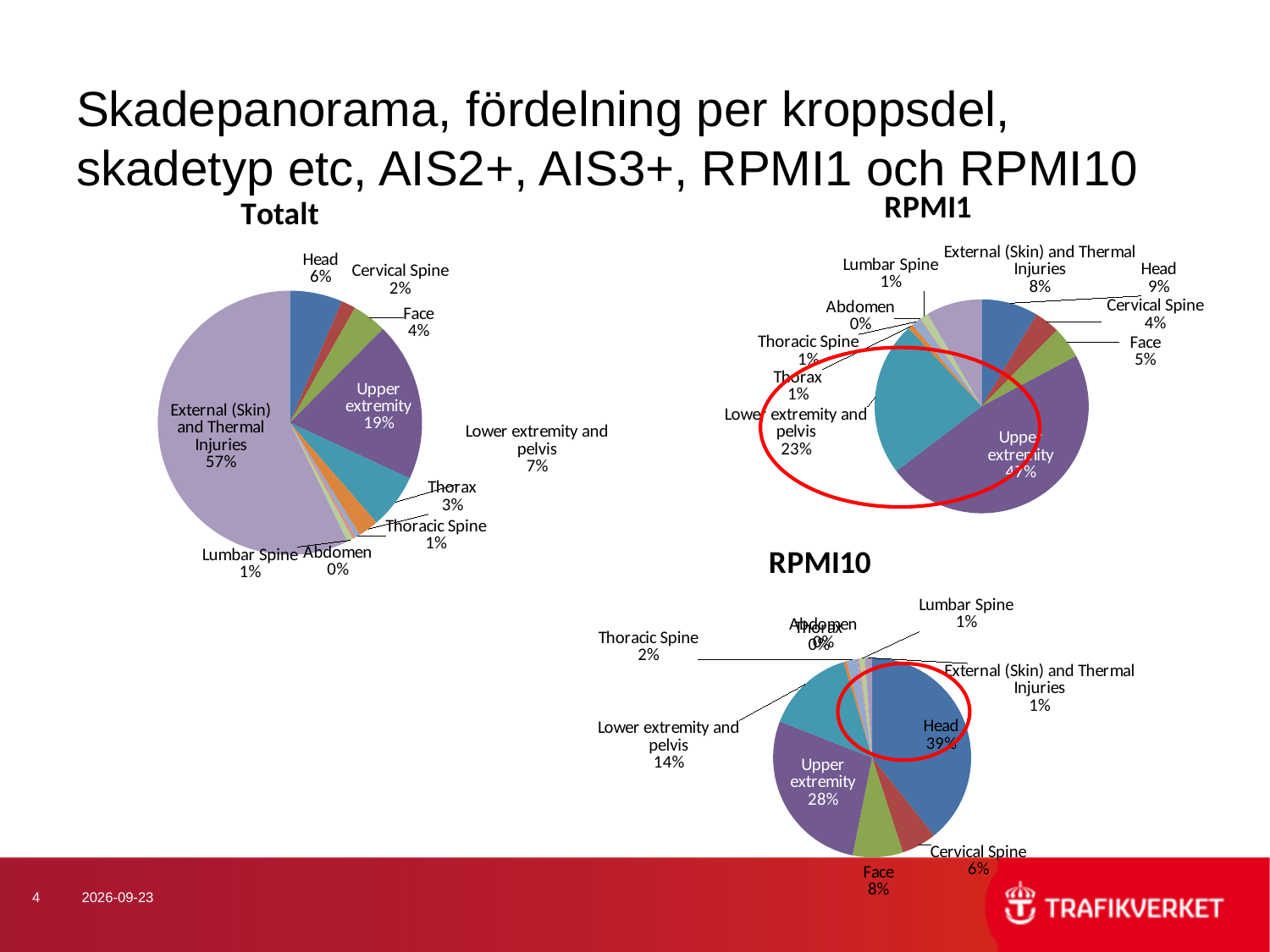
In the RPMI1 pie chart, what percentage is shown for Lower extremity and pelvis? 23% In the RPMI10 pie chart, which category has the largest share? Head What kind of chart is used for the Totalt, RPMI1 and RPMI10 data? Pie chart In the Totalt pie chart, what is the difference in percentage points between Upper extremity and Lower extremity and pelvis? 12 In the Totalt pie chart, what share is External (Skin) and Thermal Injuries? 57% In the Totalt pie chart, which category has the largest share? External (Skin) and Thermal Injuries In the RPMI10 pie chart, what percentage is shown for Head? 39% In the RPMI1 pie chart, which is larger, Face or Cervical Spine? Face In the RPMI1 pie chart, what percentage is shown for Head? 9% How many pie charts are shown on the slide? 3 In the RPMI10 pie chart, what is the difference in percentage points between Upper extremity and Lower extremity and pelvis? 14 In the Totalt pie chart, what percentage is shown for Upper extremity? 19%